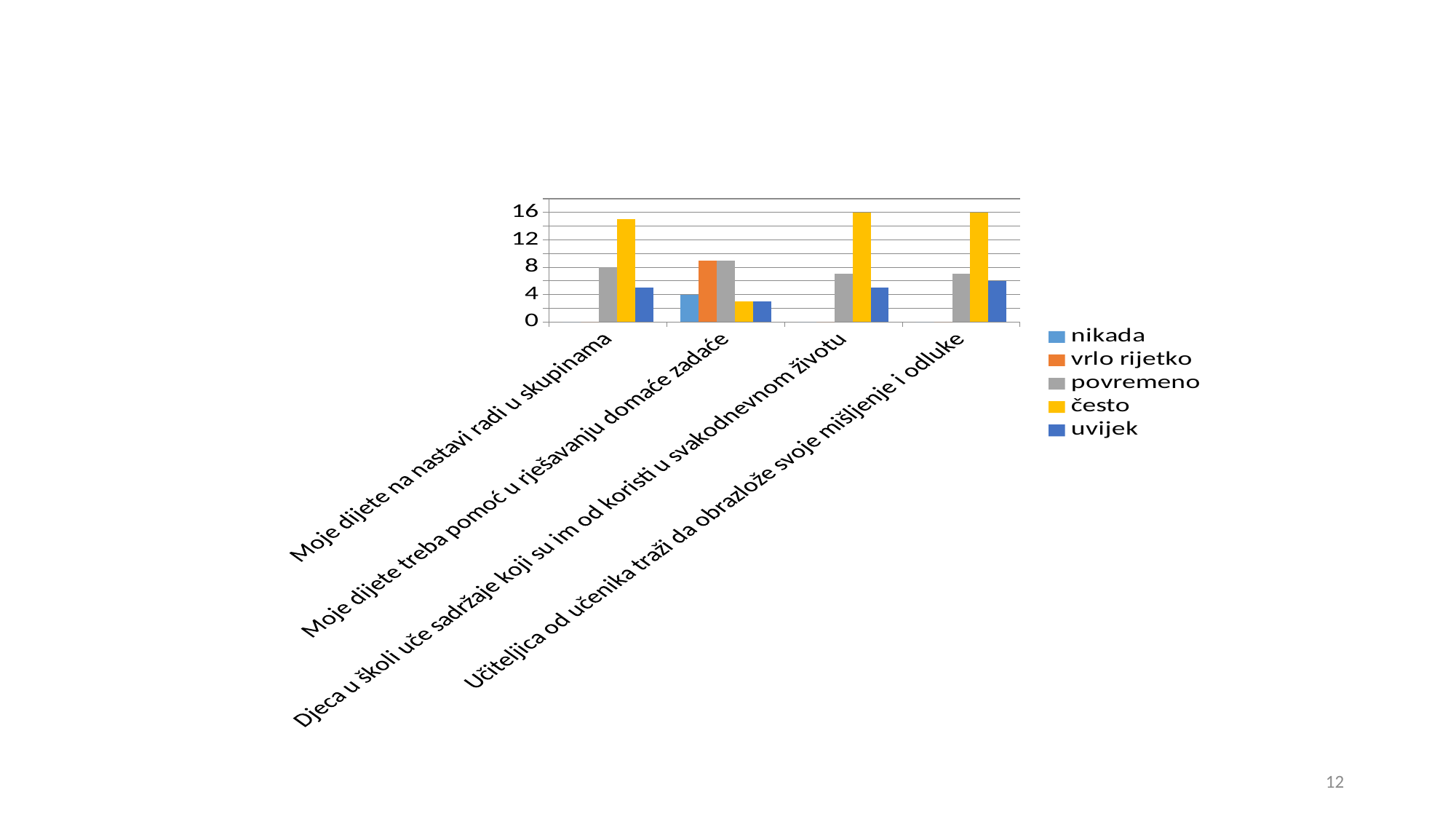
Is the value of 'često' for 'Moje dijete treba pomoć u rješavanju domaće zadaće' greater or less than 4? less For 'Moje dijete treba pomoć u rješavanju domaće zadaće', which is larger: the value for 'nikada' or the value for 'vrlo rijetko'? vrlo rijetko Is the value of 'uvijek' for 'Učiteljica od učenika traži da obrazlože svoje mišljenje i odluke' greater or less than 4? greater Which series is shown in yellow in the legend? često What kind of chart is shown on the slide? bar chart How many categories are shown on the x axis? 4 Which series has the highest value for 'Djeca u školi uče sadržaje koji su im od koristi u svakodnevnom životu'? često Which category has the only visible bar for the 'vrlo rijetko' series? Moje dijete treba pomoć u rješavanju domaće zadaće Which series has the lowest value for 'Moje dijete na nastavi radi u skupinama' among the series with visible bars? uvijek Is the value of 'često' for 'Moje dijete na nastavi radi u skupinama' greater or less than 12? greater How many series does the legend list? 5